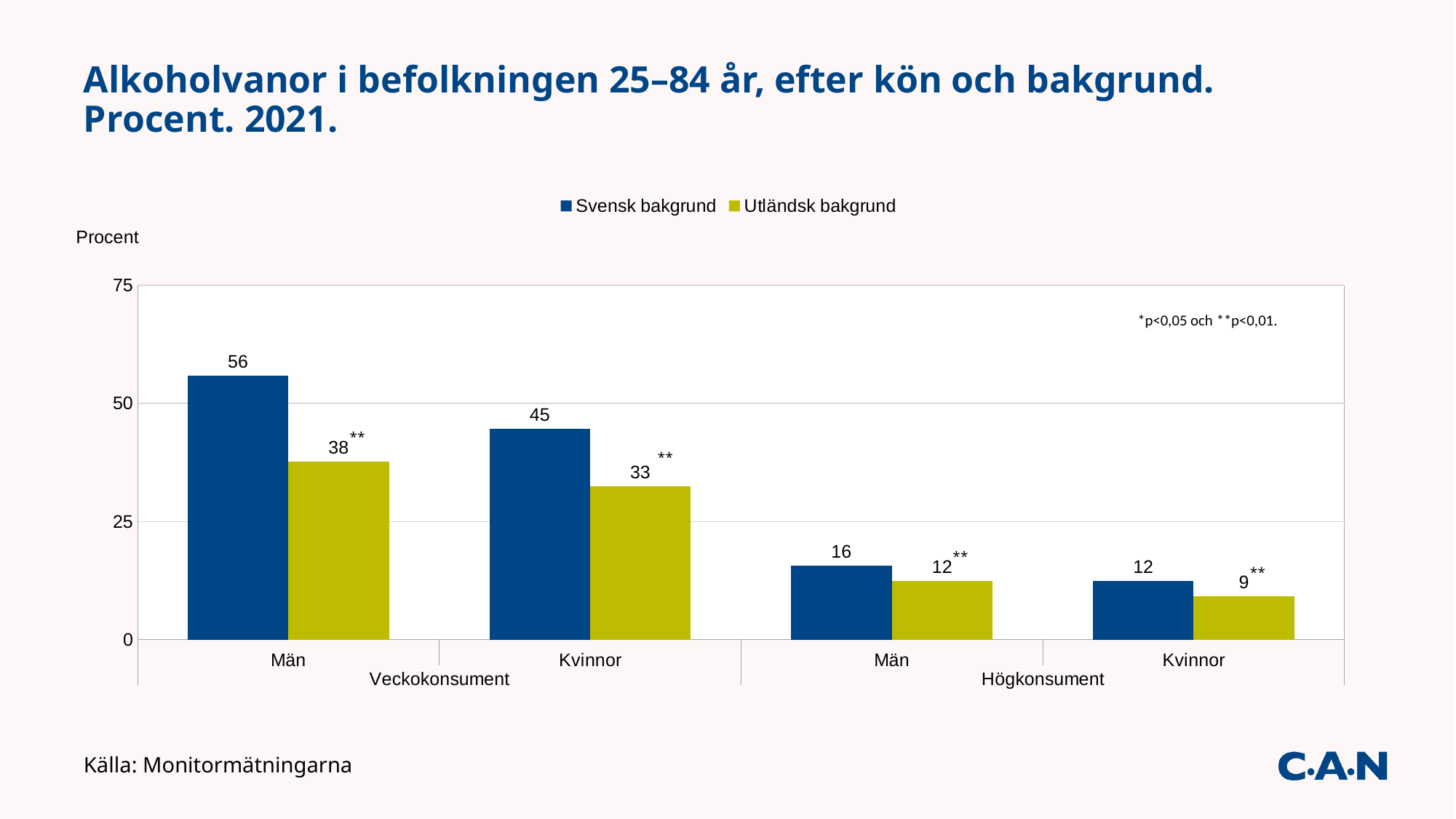
What is the value for Svensk bakgrund among Män in the Veckokonsument group? 56 Which is larger among Kvinnor in the Högkonsument group: Svensk bakgrund or Utländsk bakgrund? Svensk bakgrund Which bar has the highest value in the chart? Svensk bakgrund, Män, Veckokonsument What is the difference between Svensk bakgrund and Utländsk bakgrund among Män in the Veckokonsument group? 18 What is the source given for the chart? Monitormätningarna What kind of chart is shown on the slide? Bar chart What is the value for Svensk bakgrund among Män in the Högkonsument group? 16 What is the value for Utländsk bakgrund among Kvinnor in the Högkonsument group? 9 How many series does the legend list? 2 Which bar has the lowest value in the chart? Utländsk bakgrund, Kvinnor, Högkonsument What is the difference between Svensk bakgrund and Utländsk bakgrund among Kvinnor in the Veckokonsument group? 12 What is the value for Utländsk bakgrund among Kvinnor in the Veckokonsument group? 33